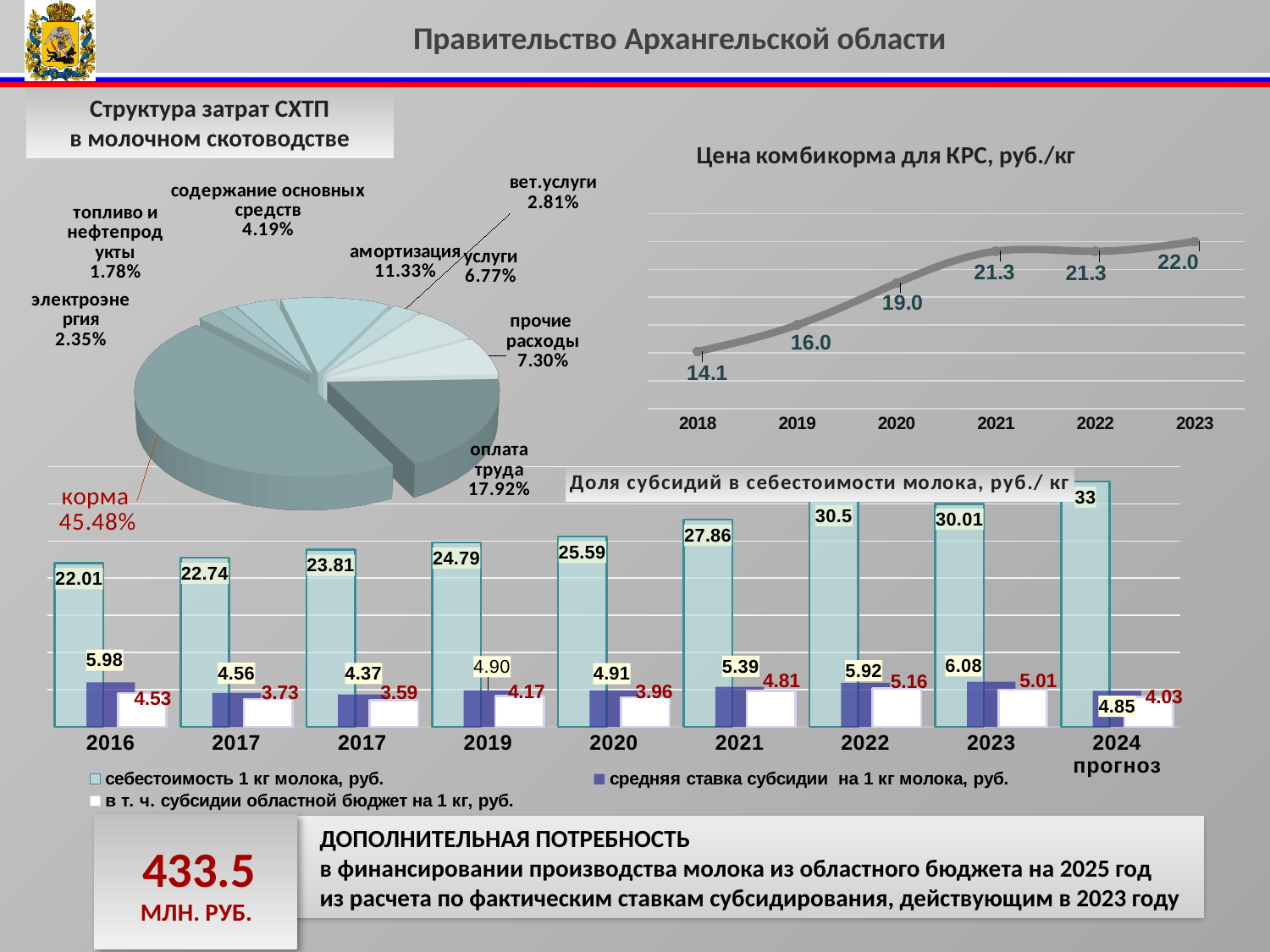
In the line chart 'Цена комбикорма для КРС, руб./кг', do the values generally rise or fall from 2018 to 2023? rise In the bar chart 'Доля субсидий в себестоимости молока, руб./ кг', what is the difference between себестоимость 1 кг молока in 2021 and 2020? 2.27 In the bar chart 'Доля субсидий в себестоимости молока, руб./ кг', which year has the highest средняя ставка субсидии на 1 кг молока? 2023 What type of chart is 'Цена комбикорма для КРС, руб./кг'? line chart In the line chart 'Цена комбикорма для КРС, руб./кг', what is the value for 2020? 19.0 How many series does the legend of the bar chart 'Доля субсидий в себестоимости молока, руб./ кг' list? 3 In the pie chart 'Структура затрат СХТП в молочном скотоводстве', what share do корма (feed) account for? 45.48% In the line chart 'Цена комбикорма для КРС, руб./кг', by how much did the price increase from 2018 to 2023? 7.9 In the bar chart 'Доля субсидий в себестоимости молока, руб./ кг', what is the себестоимость 1 кг молока for 2022? 30.5 In the pie chart 'Структура затрат СХТП в молочном скотоводстве', what is the share of оплата труда? 17.92%